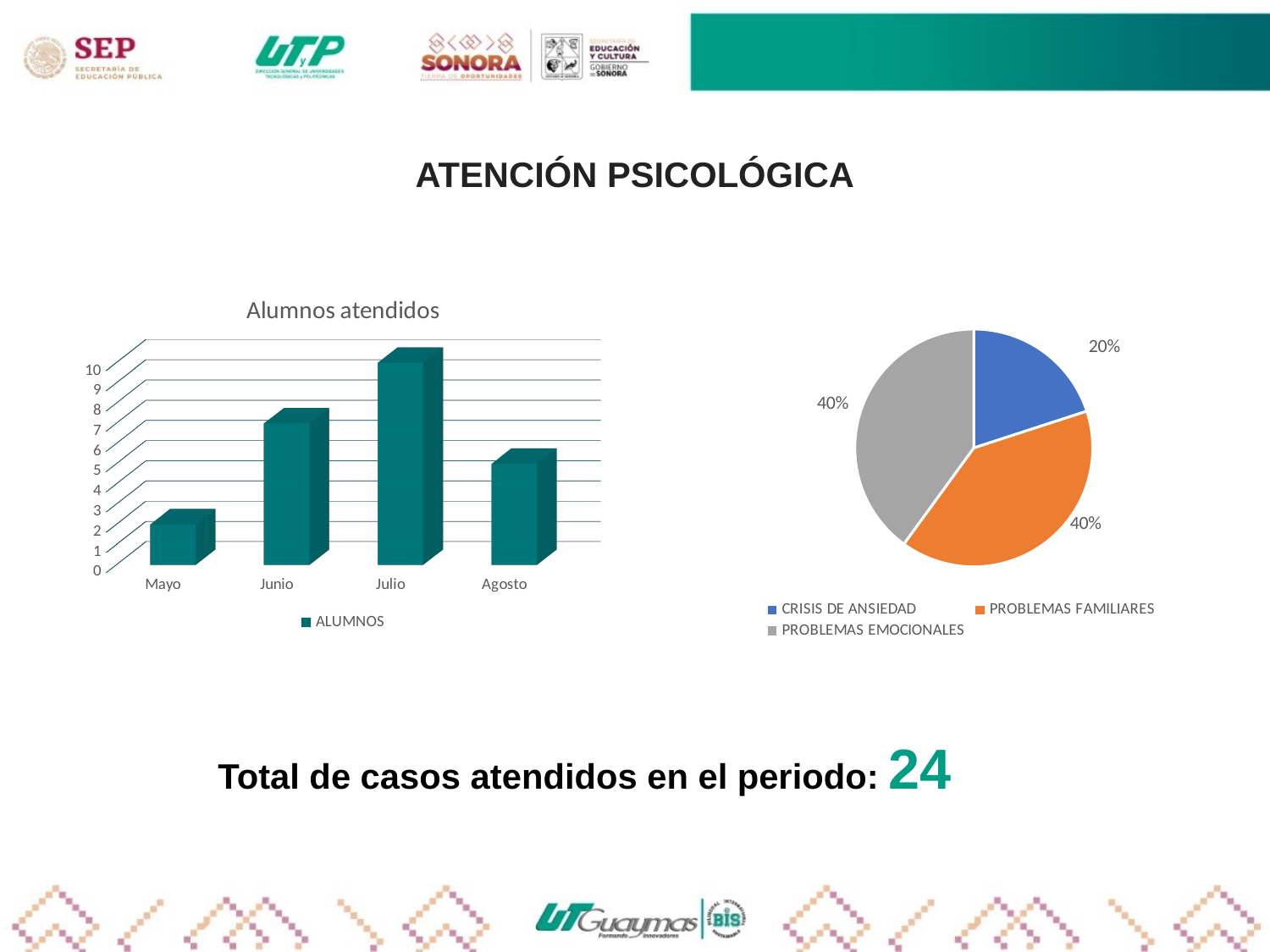
In the 'Alumnos atendidos' chart on the left, is the value for Mayo greater or less than 5? less In the 'Alumnos atendidos' chart on the left, which month has the lowest bar? Mayo How many months are shown on the x axis of the 'Alumnos atendidos' chart on the left? 4 In the pie chart on the right, what share is labelled for CRISIS DE ANSIEDAD? 20% How many categories does the legend of the pie chart on the right list? 3 In the 'Alumnos atendidos' chart on the left, do the values rise or fall from Mayo to Julio? rise In the 'Alumnos atendidos' chart on the left, which is larger, the value for Junio or the value for Agosto? Junio In the pie chart on the right, which category has the smallest slice? CRISIS DE ANSIEDAD In the 'Alumnos atendidos' chart on the left, which month has the highest bar? Julio In the 'Alumnos atendidos' chart on the left, is the value for Julio greater or less than 8? greater In the pie chart on the right, what is the difference between the share for PROBLEMAS FAMILIARES and the share for CRISIS DE ANSIEDAD? 20% What kind of chart is the 'Alumnos atendidos' chart on the left? bar chart